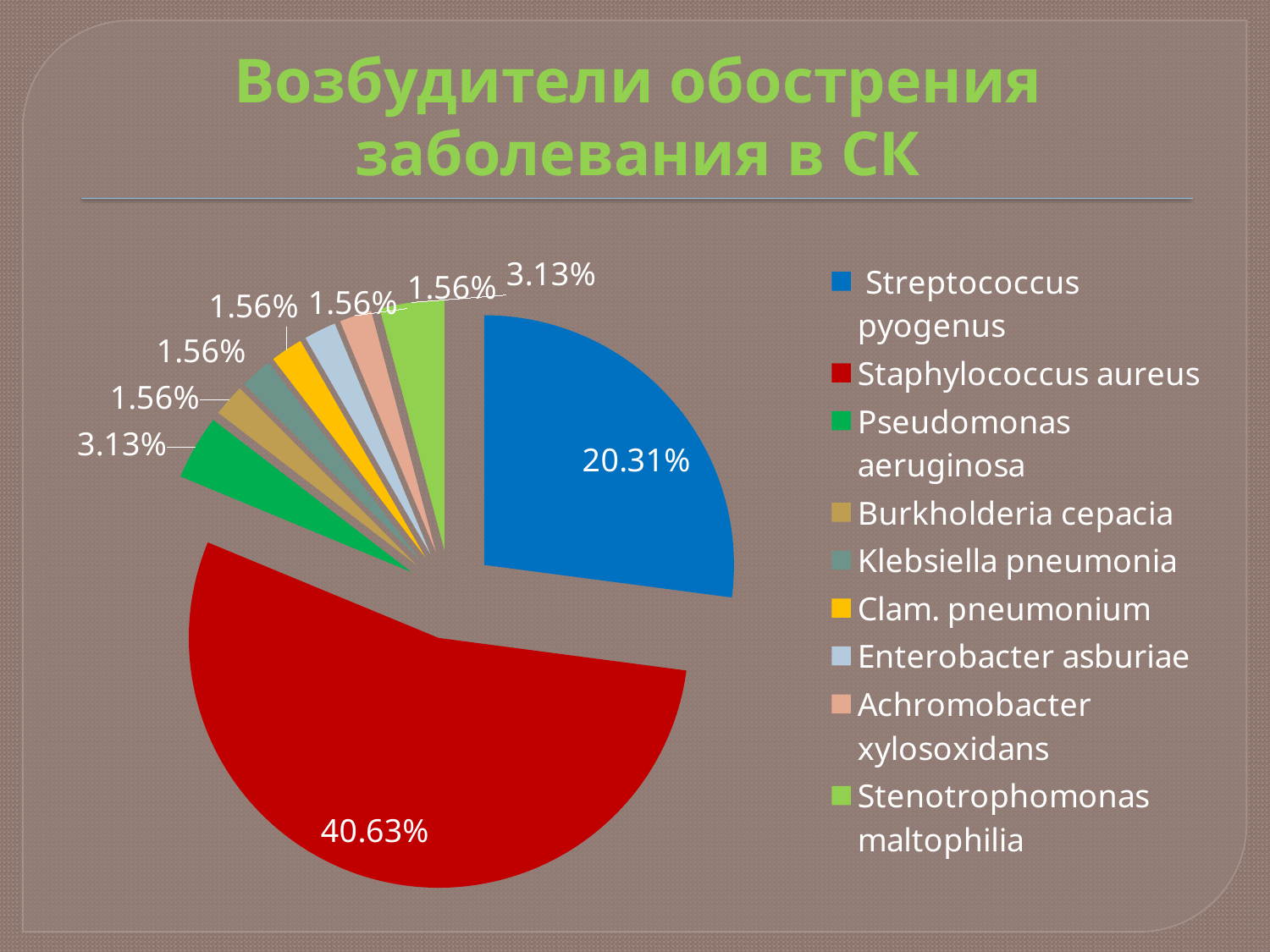
What kind of chart is shown on the slide? pie chart What is the value shown for Streptococcus pyogenus? 20.31% What is the value shown for Pseudomonas aeruginosa? 3.13% What is the title of the slide? Возбудители обострения заболевания в СК What colour is the slice for Staphylococcus aureus? red Which is larger, the slice for Staphylococcus aureus or the slice for Streptococcus pyogenus? Staphylococcus aureus Which pathogen has the largest slice of the pie? Staphylococcus aureus What is the value shown for Stenotrophomonas maltophilia? 3.13% What is the difference between the values for Staphylococcus aureus and Streptococcus pyogenus? 20.32% How many entries does the legend list? 9 What is the value shown for Clam. pneumonium? 1.56% What is the value shown for Staphylococcus aureus? 40.63%